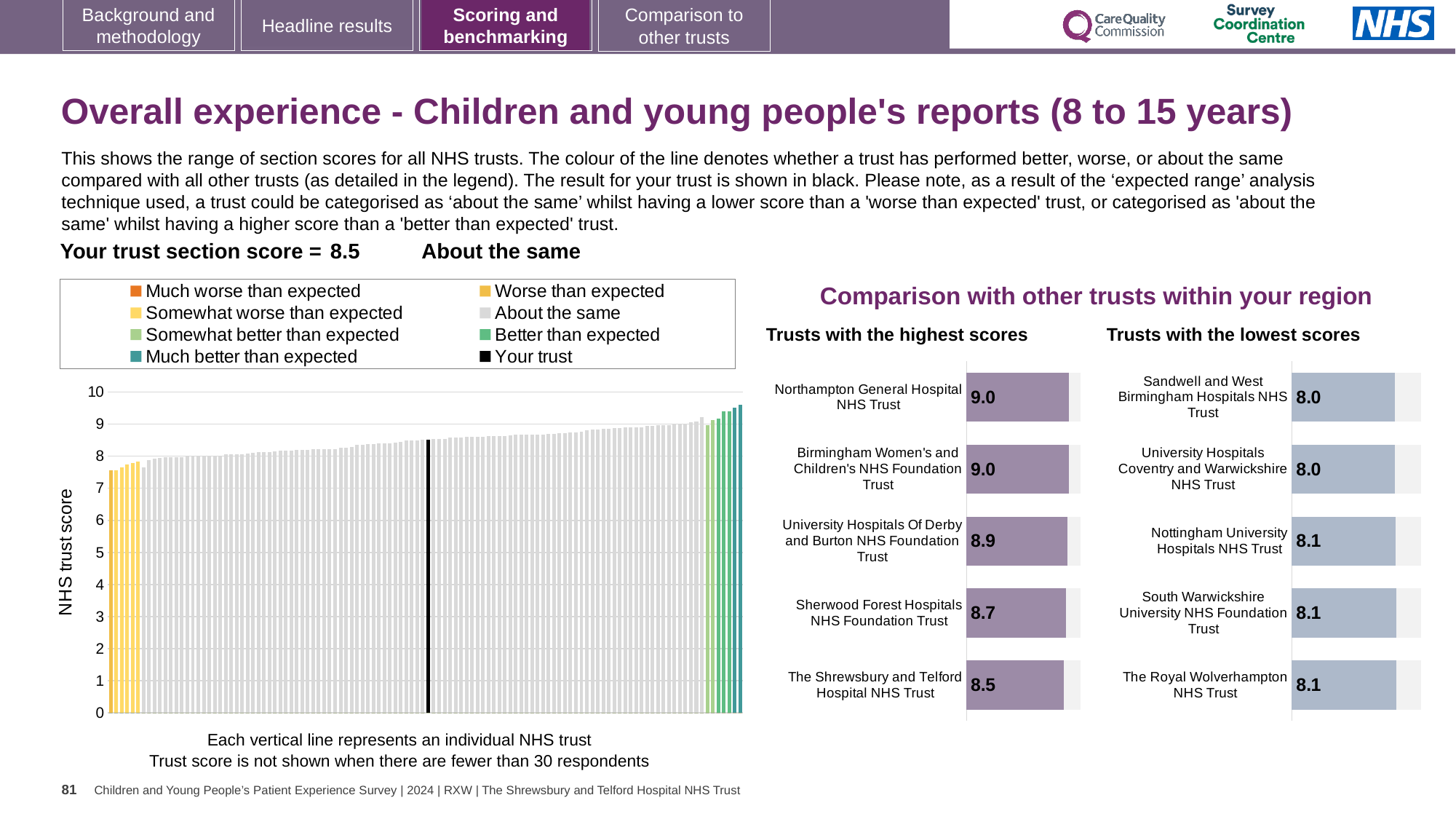
In the 'Trusts with the highest scores' chart, what is the difference between the score for Northampton General Hospital NHS Trust and the score for The Shrewsbury and Telford Hospital NHS Trust? 0.5 In the 'Trusts with the lowest scores' chart, what is the score for Nottingham University Hospitals NHS Trust? 8.1 What kind of chart is the large chart on the left showing NHS trust scores? Bar chart How many entries does the legend of the large chart on the left list? 8 In the 'Trusts with the highest scores' chart, what is the score for Northampton General Hospital NHS Trust? 9.0 In the large chart on the left, is the value for the black bar (Your trust) greater or less than 8? greater In the 'Trusts with the highest scores' chart, which trust has the lowest score? The Shrewsbury and Telford Hospital NHS Trust Which is larger: the score for Sherwood Forest Hospitals NHS Foundation Trust in the 'Trusts with the highest scores' chart, or the score for The Royal Wolverhampton NHS Trust in the 'Trusts with the lowest scores' chart? Sherwood Forest Hospitals NHS Foundation Trust In the 'Trusts with the highest scores' chart, what is the score for Sherwood Forest Hospitals NHS Foundation Trust? 8.7 In the 'Trusts with the highest scores' chart, what is the difference between the score for University Hospitals Of Derby and Burton NHS Foundation Trust and the score for Sherwood Forest Hospitals NHS Foundation Trust? 0.2 In the large chart on the left, do the bar values rise or fall from left to right along the x axis? Rise How many trusts are shown in the 'Trusts with the lowest scores' chart? 5